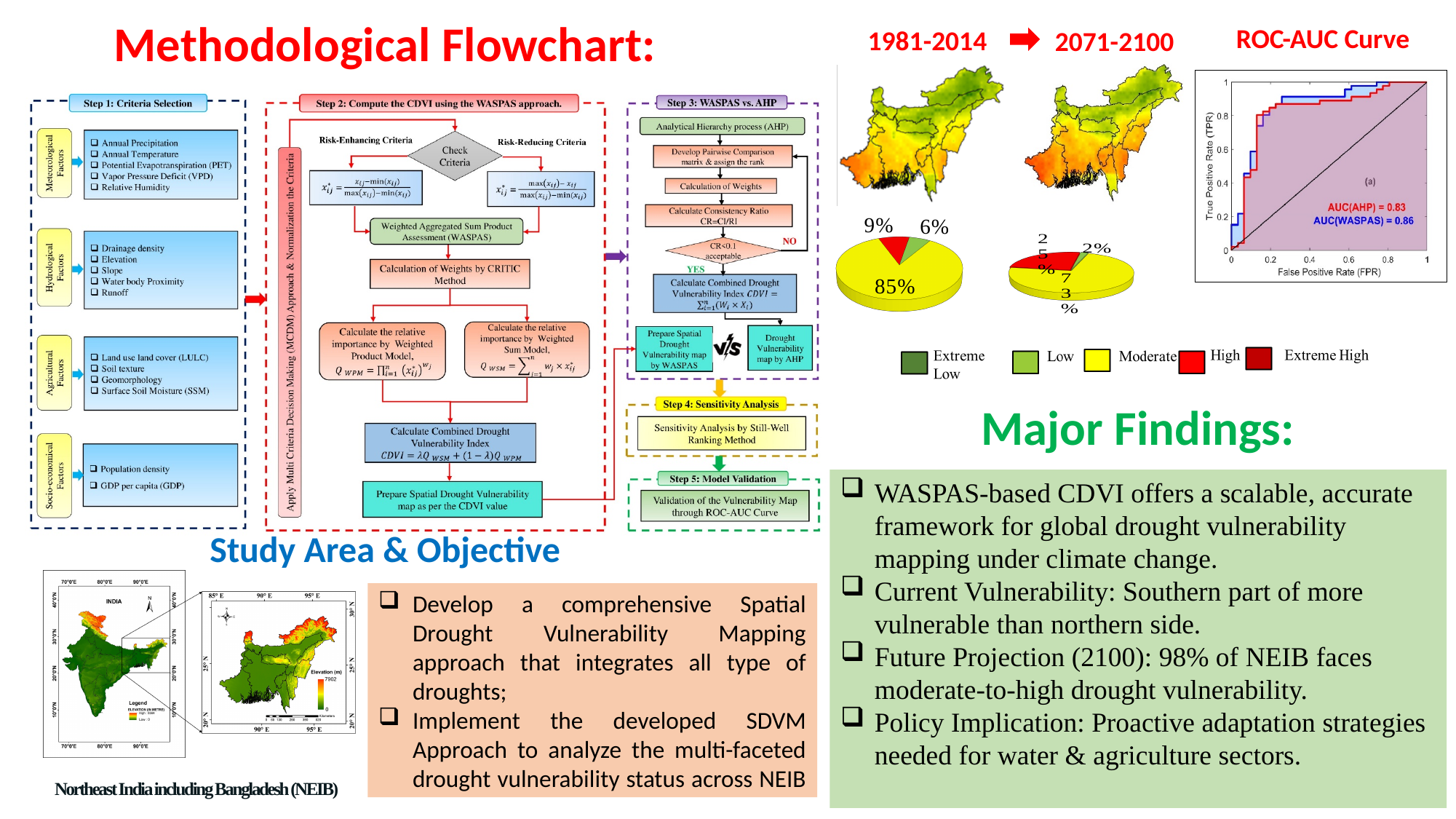
How many vulnerability classes does the legend below the pie charts list? 5 In the 1981-2014 pie chart, which vulnerability class has the largest slice? Moderate In the 2071-2100 pie chart, what share is labelled for the High (red) slice? 25% In the 1981-2014 pie chart, what share of the area is in the Moderate vulnerability class? 85% What kind of chart is used to show the vulnerability class shares for 1981-2014 and 2071-2100? Pie chart In the 1981-2014 pie chart, what share is labelled for the Low (green) slice? 6% By how many percentage points does the High slice increase from the 1981-2014 pie chart to the 2071-2100 pie chart? 16 percentage points In the ROC-AUC Curve chart, which method has the higher AUC, AHP or WASPAS? WASPAS In the ROC-AUC Curve chart, what is the AUC value for WASPAS? 0.86